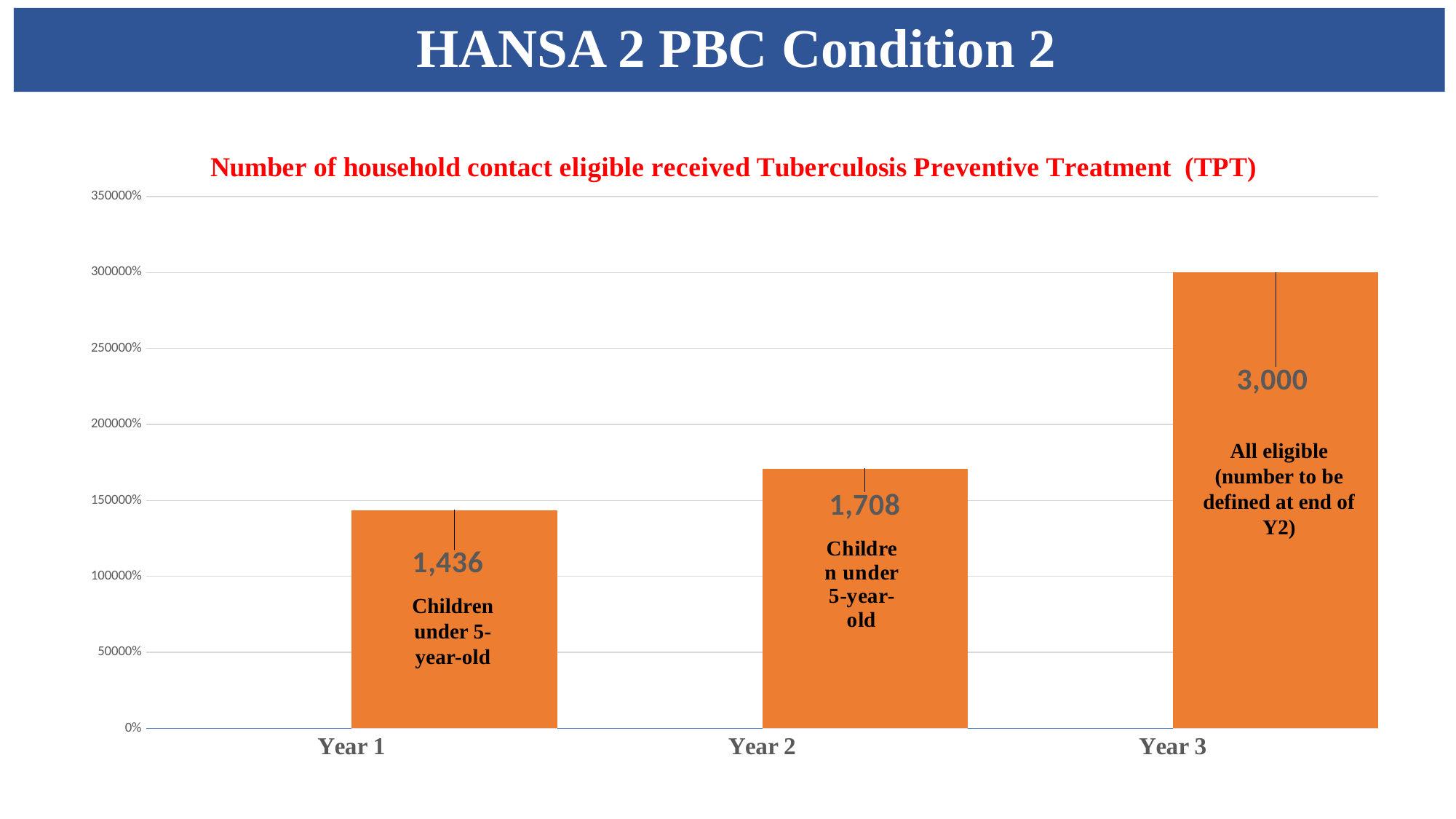
Do the values rise or fall from Year 1 to Year 3? Rise Which year has the lowest value? Year 1 What is the title of the chart? Number of household contact eligible received Tuberculosis Preventive Treatment (TPT) What is the difference between the values for Year 3 and Year 2? 1,292 What is the value for Year 3? 3,000 What is the value for Year 2? 1,708 What is the value for Year 1? 1,436 What is the difference between the values for Year 2 and Year 1? 272 Which year has the highest value? Year 3 What kind of chart is shown on the slide? Bar chart Which is larger, the value for Year 1 or the value for Year 2? Year 2 How many years are shown on the x axis? 3